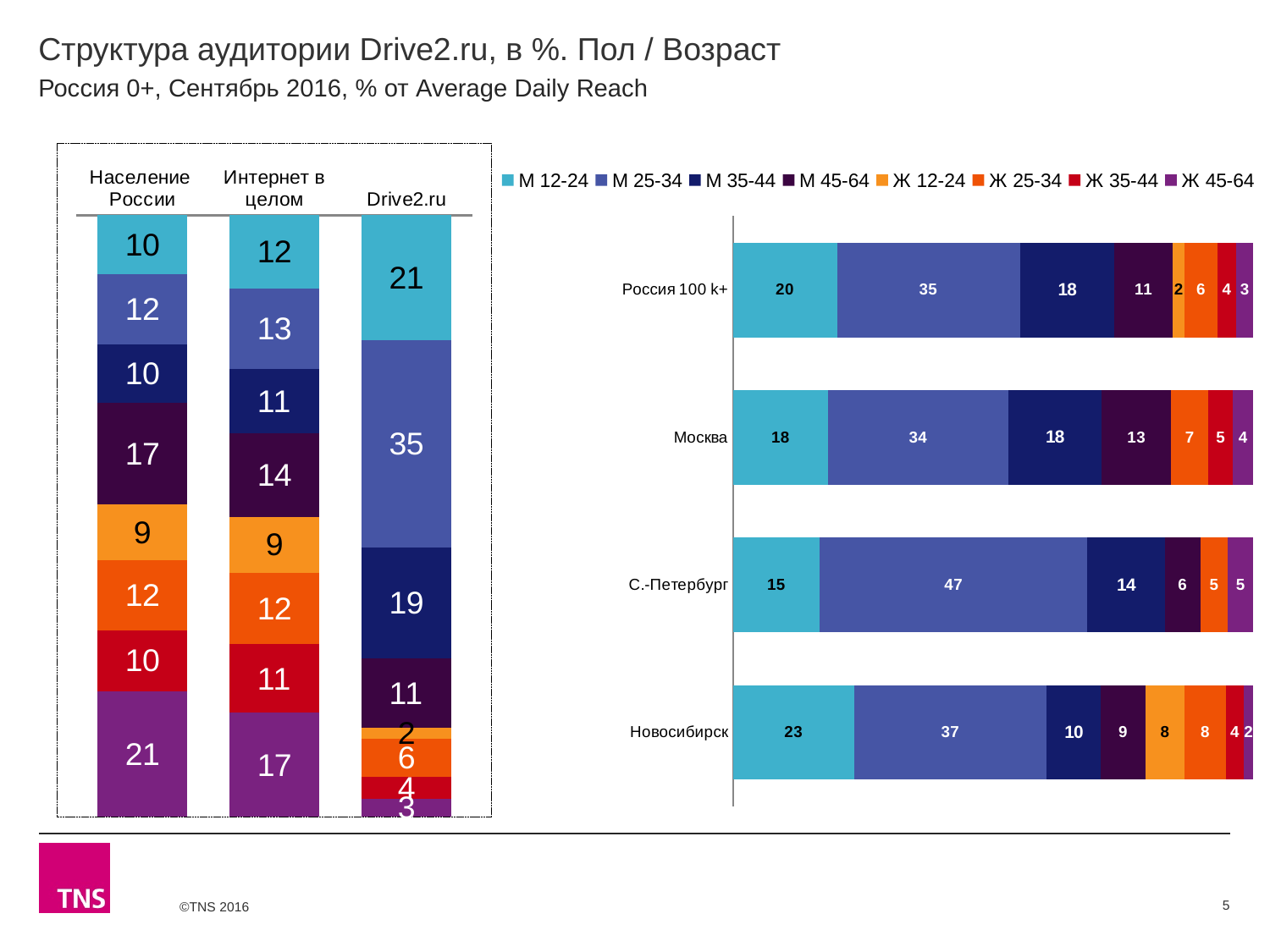
In the left-hand chart, what is the value of the М 25-34 segment for Drive2.ru? 35 In the left-hand chart, which is larger: the Ж 45-64 value for Население России or for Drive2.ru? Население России How many categories (bars) are shown in the right-hand chart? 4 What kind of chart is the right-hand chart? Stacked bar chart In the right-hand chart, what is the value of the М 25-34 segment for С.-Петербург? 47 How many series does the legend on the slide list? 8 In the right-hand chart, which is larger: the М 35-44 value for Москва or for Новосибирск? Москва In the right-hand chart, which city or region has the highest М 25-34 value? С.-Петербург In the right-hand chart, which city or region has the lowest М 12-24 value? С.-Петербург In the right-hand chart, what is the value of the М 12-24 segment for Новосибирск? 23 In the left-hand chart, what is the difference between the М 25-34 values for Drive2.ru and Интернет в целом? 22 In the left-hand chart, what is the value of the Ж 45-64 segment for Население России? 21